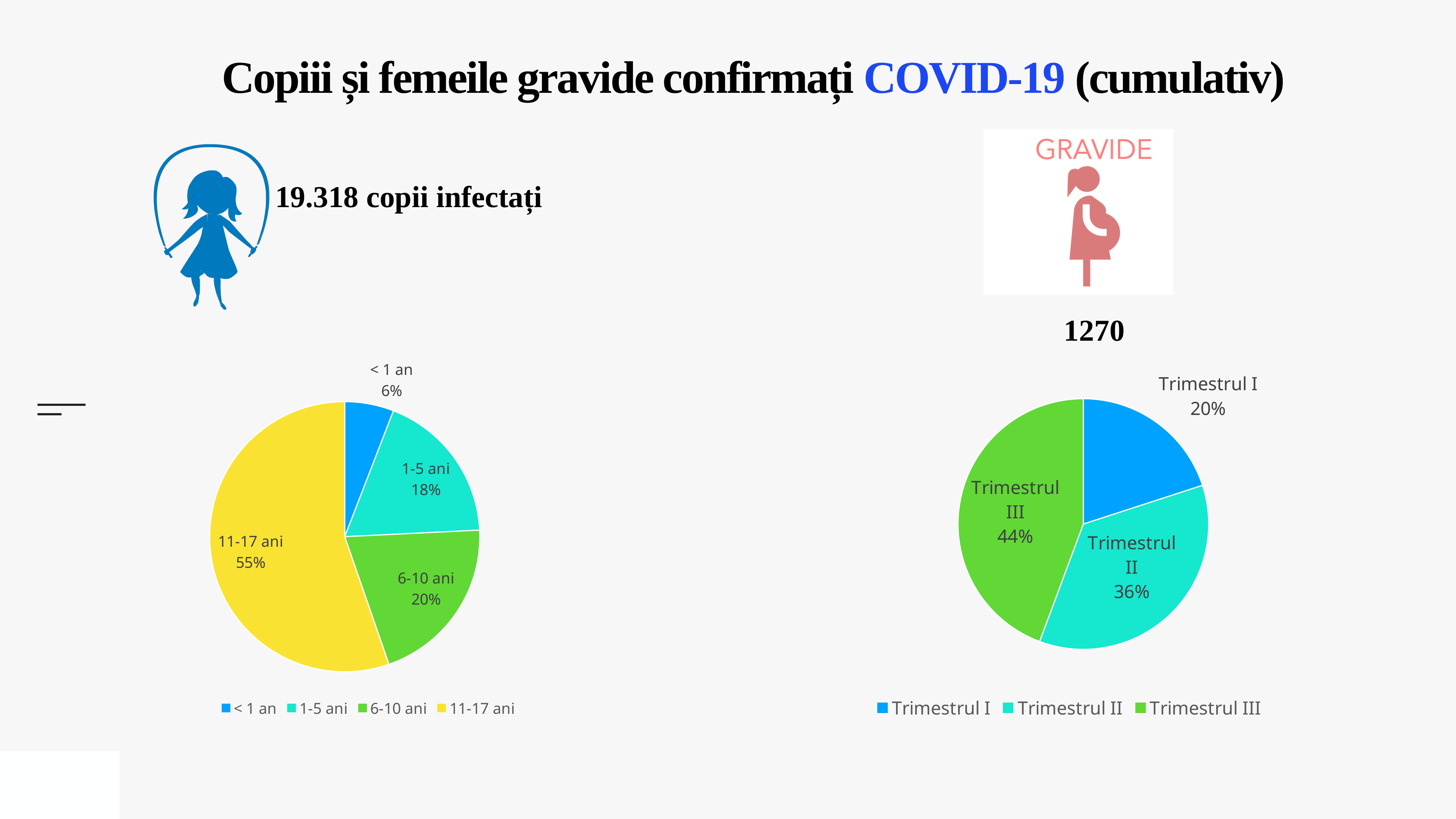
In the left pie chart (children by age), how many slices does the pie have? 4 In the right pie chart (pregnant women by trimester), which trimester has the largest share? Trimestrul III In the right pie chart (pregnant women by trimester), which trimester has the smallest share? Trimestrul I In the right pie chart (pregnant women by trimester), which is larger: Trimestrul I or Trimestrul II? Trimestrul II In the left pie chart (children by age), which age group has the largest share? 11-17 ani In the left pie chart (children by age), what share is shown for the < 1 an slice? 6% In the left pie chart (children by age), which age group has the smallest share? < 1 an In the right pie chart (pregnant women by trimester), how many entries does the legend list? 3 In the left pie chart (children by age), what is the difference in percentage points between the 6-10 ani and 1-5 ani slices? 2 In the right pie chart (pregnant women by trimester), what share is shown for Trimestrul II? 36% In the left pie chart (children by age), what share is shown for the 11-17 ani slice? 55% What type of chart is used on the right side of the slide for pregnant women by trimester? Pie chart